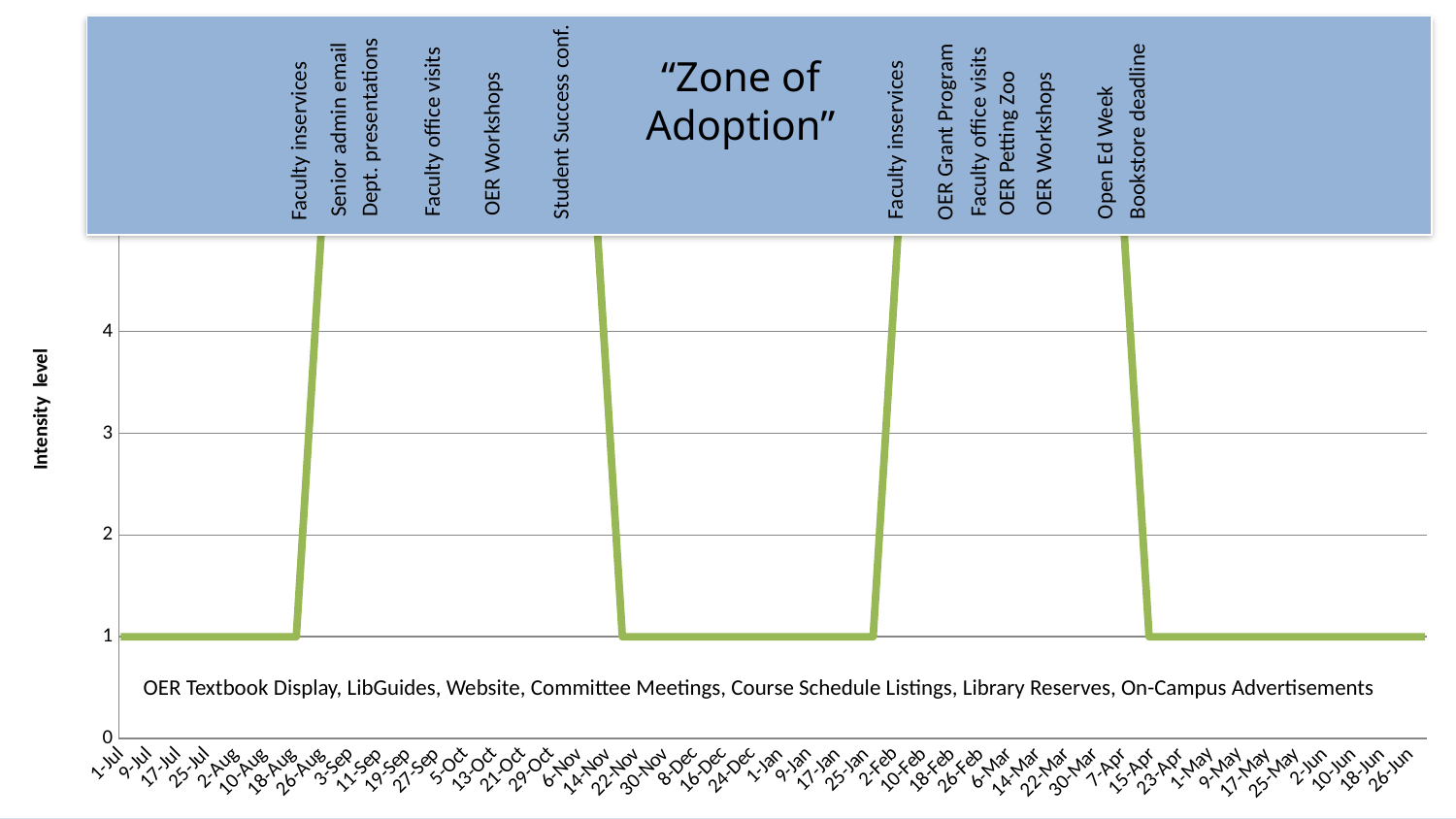
Is the intensity level on 6-Mar greater or less than 3? greater Which has the higher intensity level, 1-Jul or 3-Sep? 3-Sep What is the intensity level on 26-Jun? 1 What is the intensity level on 1-Jan? 1 Is the intensity level on 8-Dec greater or less than 2? less Is the intensity level on 3-Sep greater or less than 4? greater Which has the lower intensity level, 10-Feb or 23-Apr? 23-Apr How does the intensity level change between 1-Jul and 18-Aug? It stays flat at 1 What phrase in quotation marks appears in the blue band above the chart? "Zone of Adoption" What is the intensity level on 1-Jul? 1 What kind of chart is shown on the slide? line chart What is the label on the y axis of the chart? Intensity level